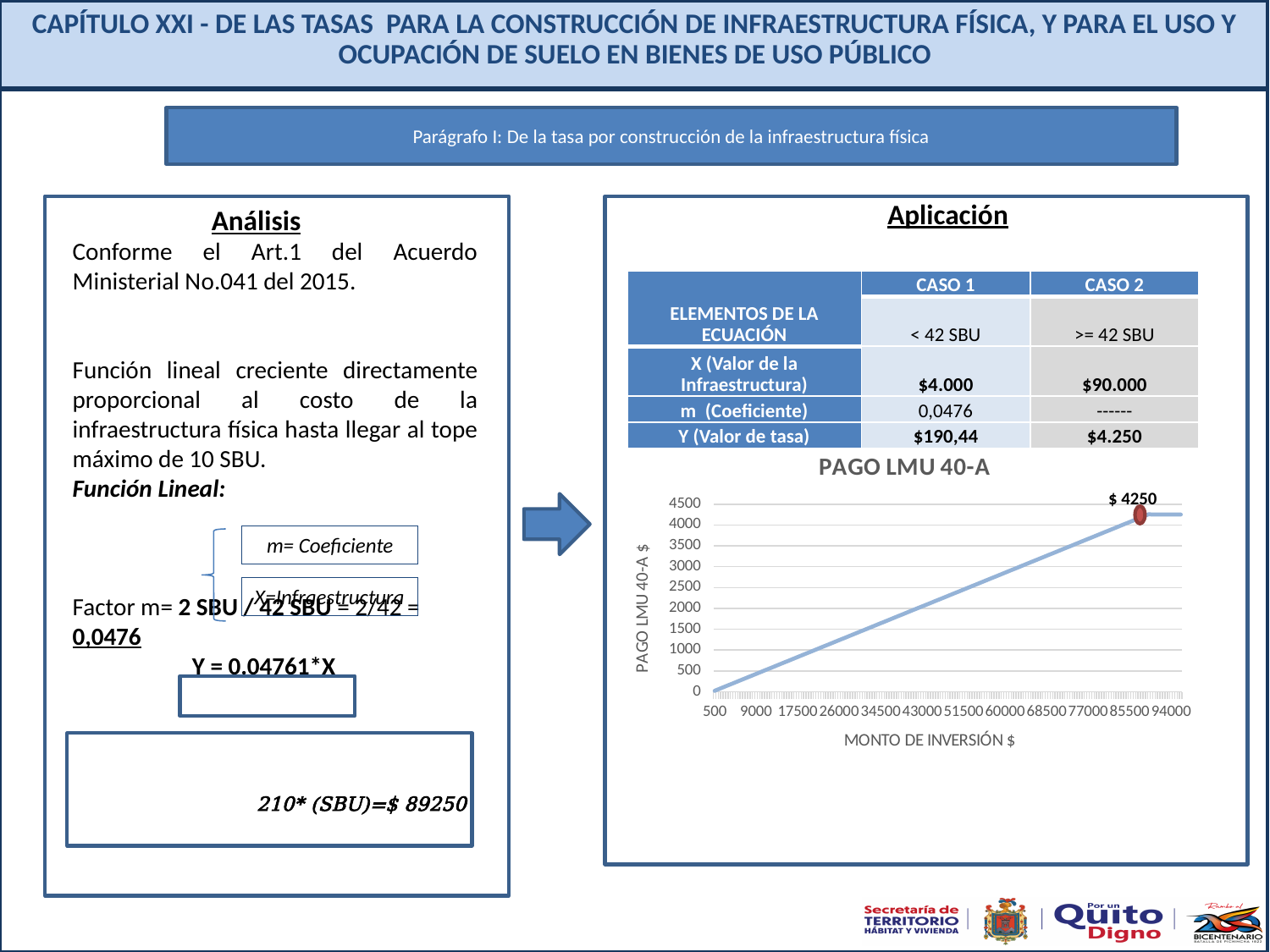
Is the value of the line at an investment amount of 94000 greater or less than 4000? greater Does the line in the chart rise or fall as the investment amount increases along the x axis? rise Is the value of the line at an investment amount of 43000 greater or less than 1500? greater Which investment amount has the higher plotted value, 9000 or 77000? 77000 Is the value of the line at an investment amount of 500 greater or less than 500? less What value is printed as the data label at the top of the line in the chart? $ 4250 What kind of chart is shown on the slide? line chart What is the highest tick value shown on the y axis of the chart? 4500 What is the x-axis title of the chart? MONTO DE INVERSIÓN $ What is the title of the chart? PAGO LMU 40-A How many tick labels are shown on the x axis of the chart? 12